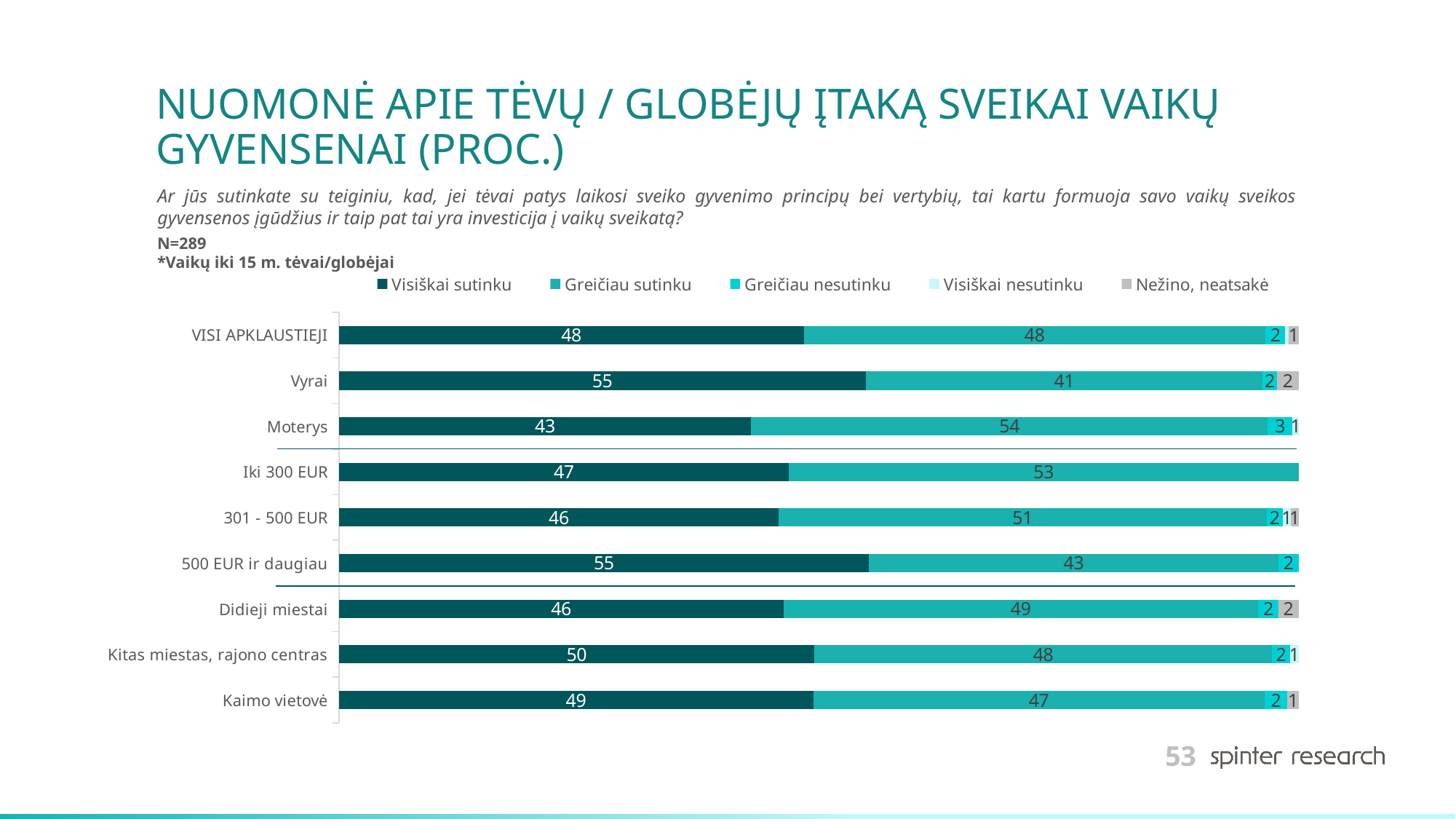
What kind of chart is shown on the slide? Stacked bar chart What is the value for "Greičiau sutinku" in the "Vyrai" bar? 41 What is the total of the "Iki 300 EUR" bar? 100 What is the value for "Visiškai sutinku" in the "Kitas miestas, rajono centras" bar? 50 How many categories are shown on the chart? 9 What is the value for "Visiškai sutinku" in the "VISI APKLAUSTIEJI" bar? 48 Which category has the lowest value for "Visiškai sutinku"? Moterys What is the value for "Greičiau sutinku" in the "500 EUR ir daugiau" bar? 43 How many series does the legend list? 5 Which category has the highest value for "Greičiau sutinku"? Moterys What is the difference between the "Visiškai sutinku" values for "Vyrai" and "Moterys"? 12 In the "Iki 300 EUR" bar, which is larger: "Visiškai sutinku" or "Greičiau sutinku"? Greičiau sutinku